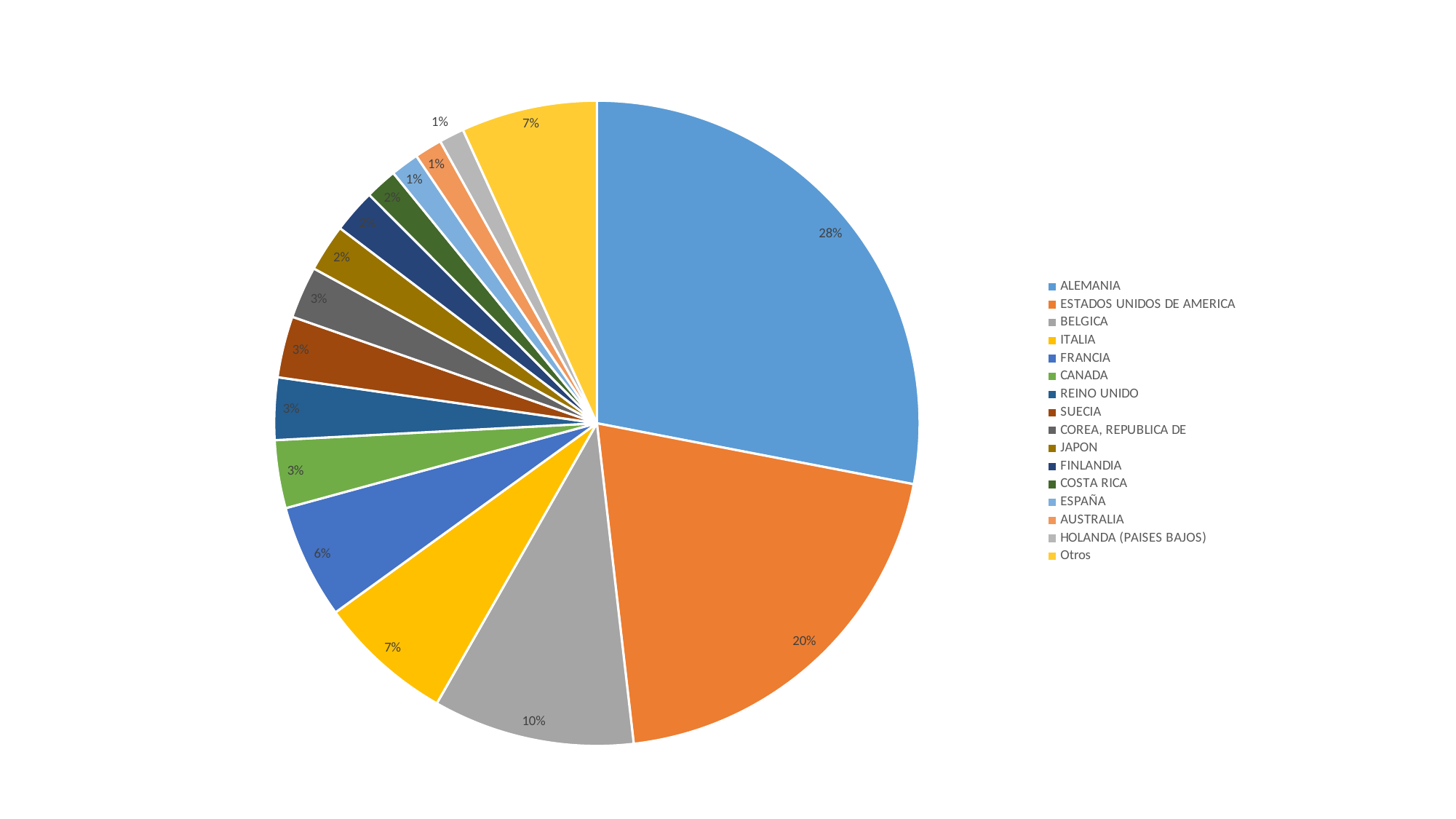
What share of the pie does ALEMANIA hold? 28% What percentage is shown for ESTADOS UNIDOS DE AMERICA? 20% Which category has the largest slice of the pie? ALEMANIA How many categories does the legend list? 16 What kind of chart is shown on the slide? Pie chart What percentage is shown for the Otros slice? 7% What is the combined share of ITALIA and FRANCIA? 13% What is the difference between the ALEMANIA and ESTADOS UNIDOS DE AMERICA shares? 8% What percentage does the FRANCIA slice show? 6% Which is larger, the BELGICA slice or the ITALIA slice? BELGICA What colour is the ALEMANIA slice? Blue What is the value labelled for BELGICA? 10%